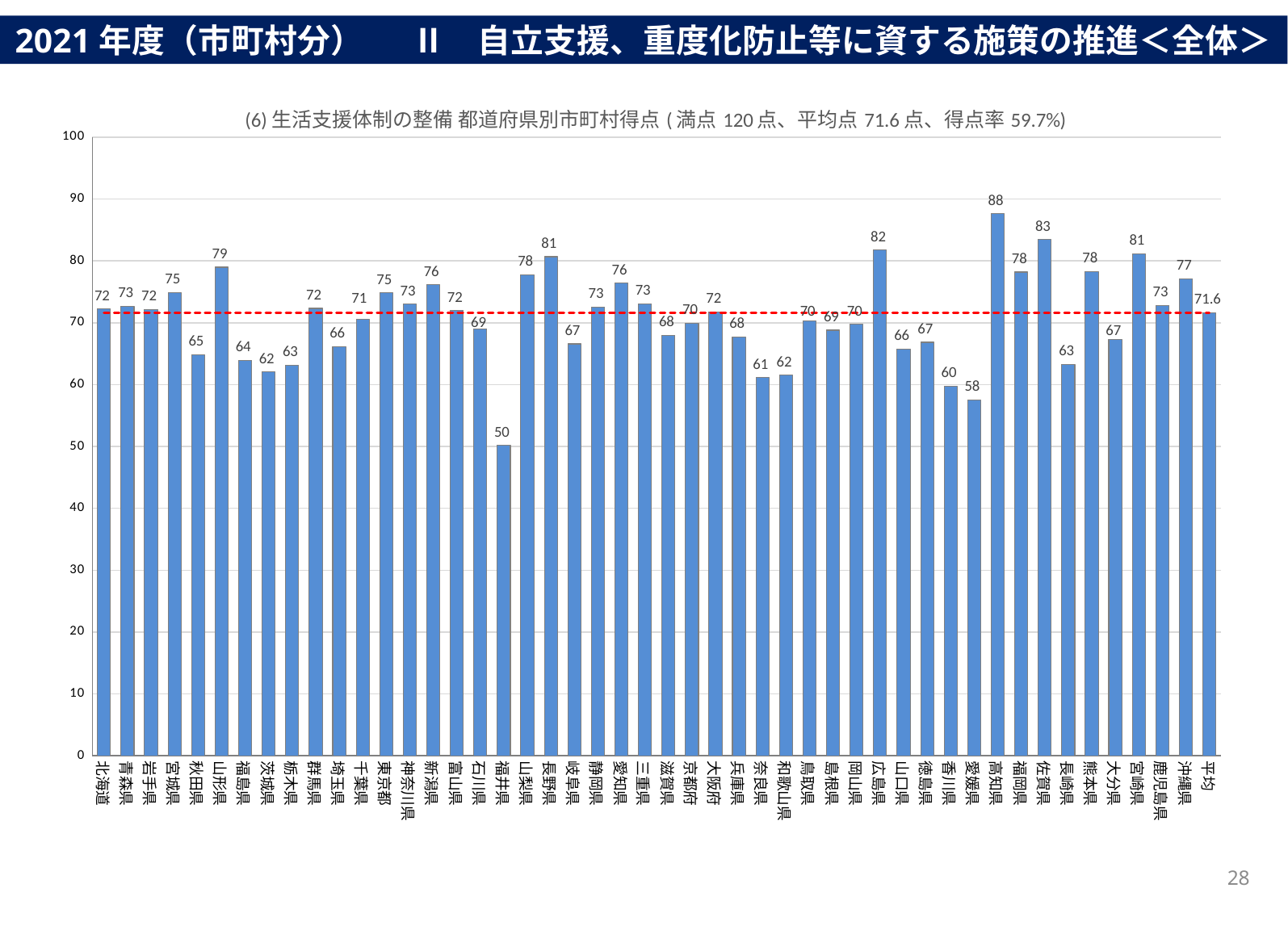
Which prefecture has the highest value? 高知県 Which prefecture has the lowest value? 福井県 What is the value for 平均 (the last bar)? 71.6 What is the value for 高知県? 88 What is the value for 長野県? 81 What is the difference between the values for 高知県 and 福井県? 38 Is the value for 愛媛県 greater or less than 60? less Which has a larger value, 佐賀県 or 広島県? 佐賀県 What type of chart is shown on the slide? bar chart What average score (平均点) is stated in the chart title? 71.6 点 What is the value for 福井県? 50 What is the difference between the values for 山形県 and 福島県? 15